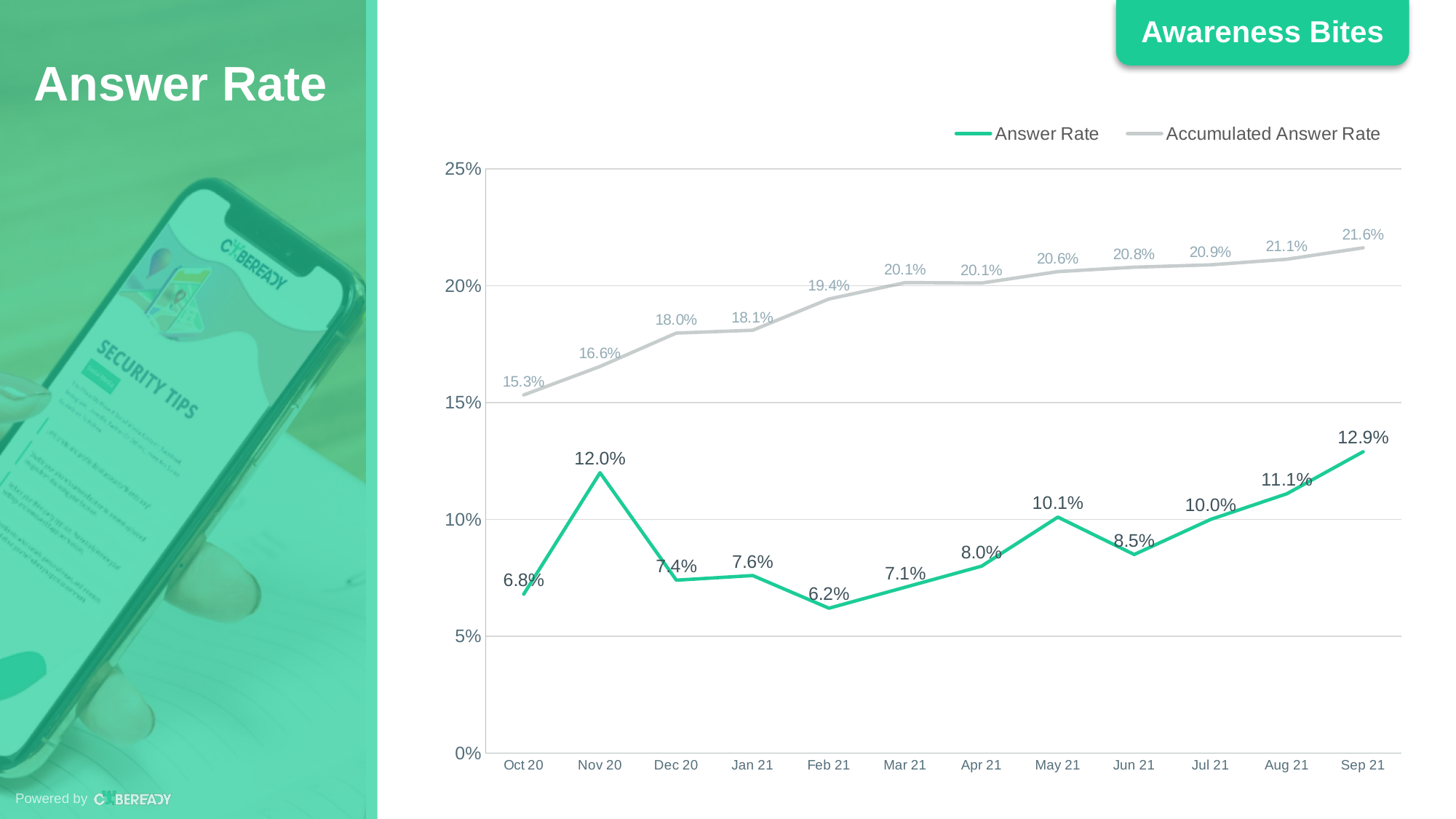
Which month has the lowest Answer Rate? Feb 21 What is the Accumulated Answer Rate for Sep 21? 21.6% Which month has the highest Answer Rate? Sep 21 Is the Accumulated Answer Rate for Oct 20 greater or less than 20%? less What kind of chart is shown on the slide? line chart What is the Answer Rate for Nov 20? 12.0% Does the Accumulated Answer Rate rise or fall from Oct 20 to Sep 21? rise How many months are shown on the x axis? 12 Which is larger, the Answer Rate in May 21 or in Jun 21? May 21 What is the difference between the Answer Rate in Sep 21 and Oct 20? 6.1% What is the Answer Rate for Feb 21? 6.2% How many series does the legend list? 2